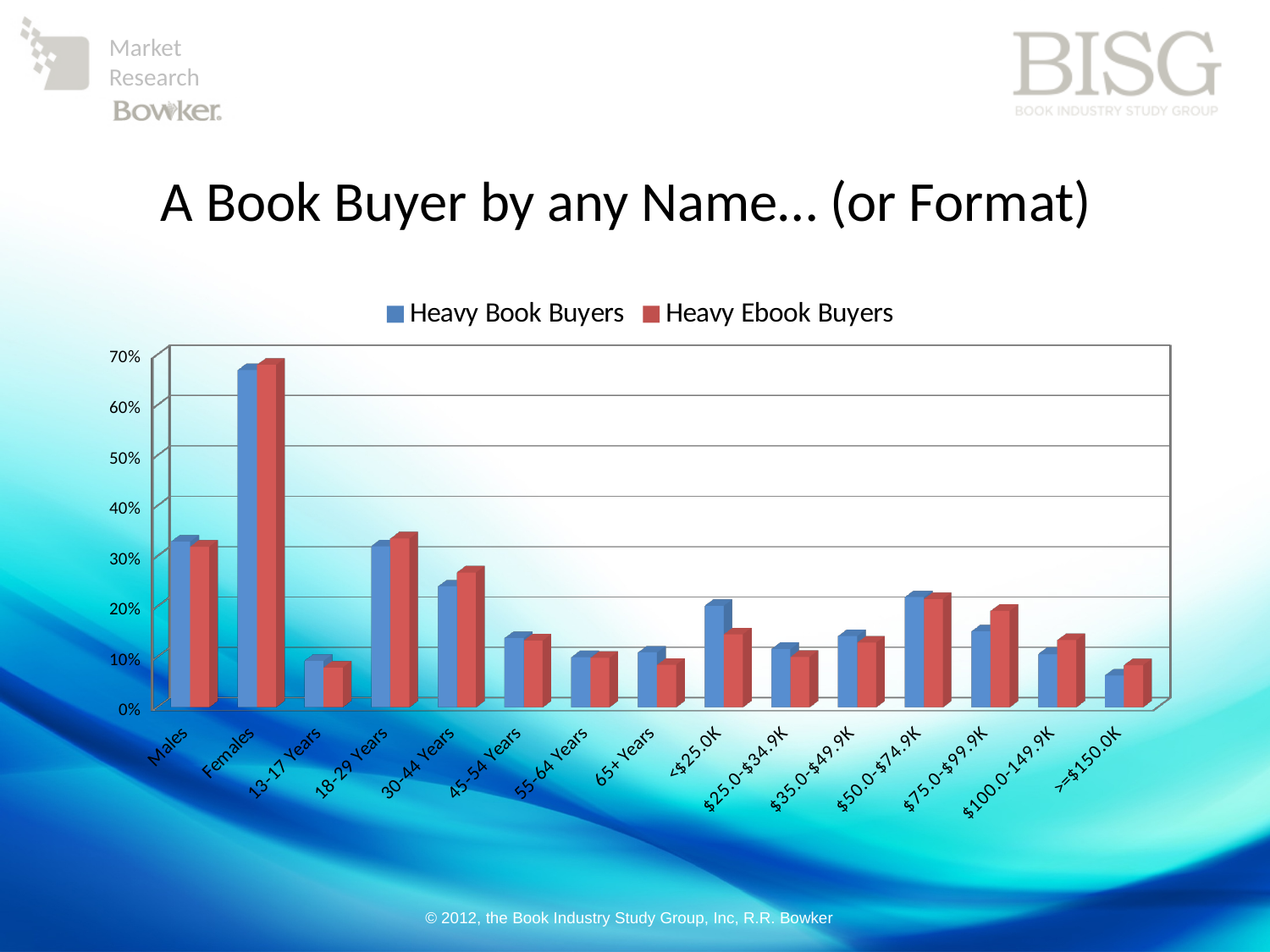
Is the Heavy Book Buyers value for Females greater or less than 60%? greater What kind of chart is shown on the slide? Bar chart Which category has the highest value for Heavy Book Buyers? Females How many series does the chart legend list? 2 Which category has the highest value for Heavy Ebook Buyers? Females Which category has the lowest value for Heavy Book Buyers? >=$150.0K Is the Heavy Ebook Buyers value for 18-29 Years greater or less than 30%? greater How many categories are shown along the x axis of the chart? 15 Which colour represents Heavy Ebook Buyers in the chart legend? Red Is the Heavy Book Buyers value for >=$150.0K greater or less than 10%? less For the <$25.0K category, which series has the larger value, Heavy Book Buyers or Heavy Ebook Buyers? Heavy Book Buyers For the $75.0-$99.9K category, which series has the larger value, Heavy Book Buyers or Heavy Ebook Buyers? Heavy Ebook Buyers